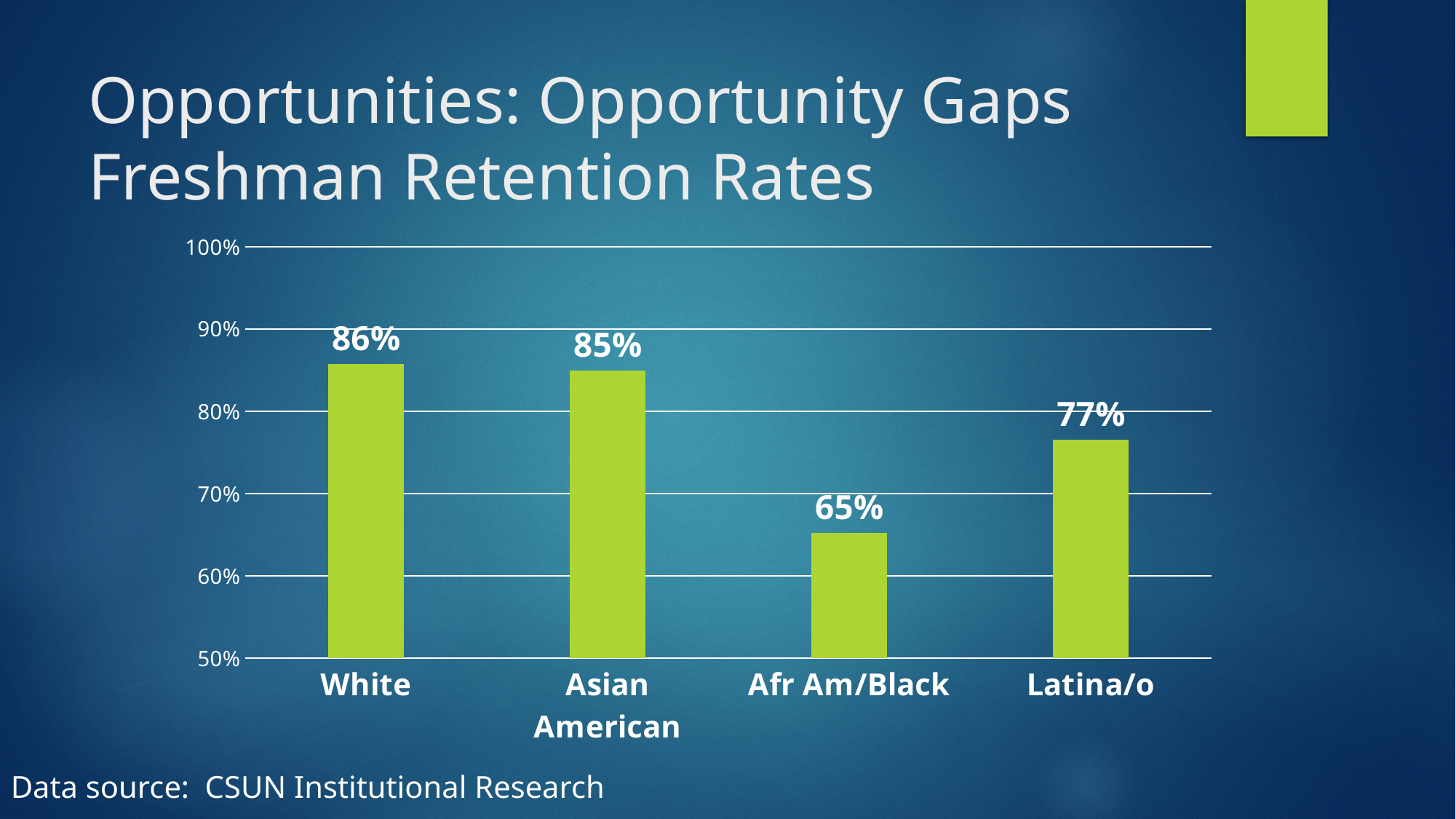
Which group has the lowest freshman retention rate? Afr Am/Black What is the difference between the retention rates for White and Afr Am/Black students? 21% Which is larger, the retention rate for Latina/o students or for Afr Am/Black students? Latina/o What is the freshman retention rate for Latina/o students? 77% Is the retention rate for Latina/o students greater or less than 80%? less What kind of chart is shown on the slide? bar chart What is the freshman retention rate for White students? 86% What is the freshman retention rate for Asian American students? 85% How many groups are shown in the chart? 4 Which group has the highest freshman retention rate? White What is the difference between the retention rates for Asian American and Latina/o students? 8% What is the freshman retention rate for Afr Am/Black students? 65%